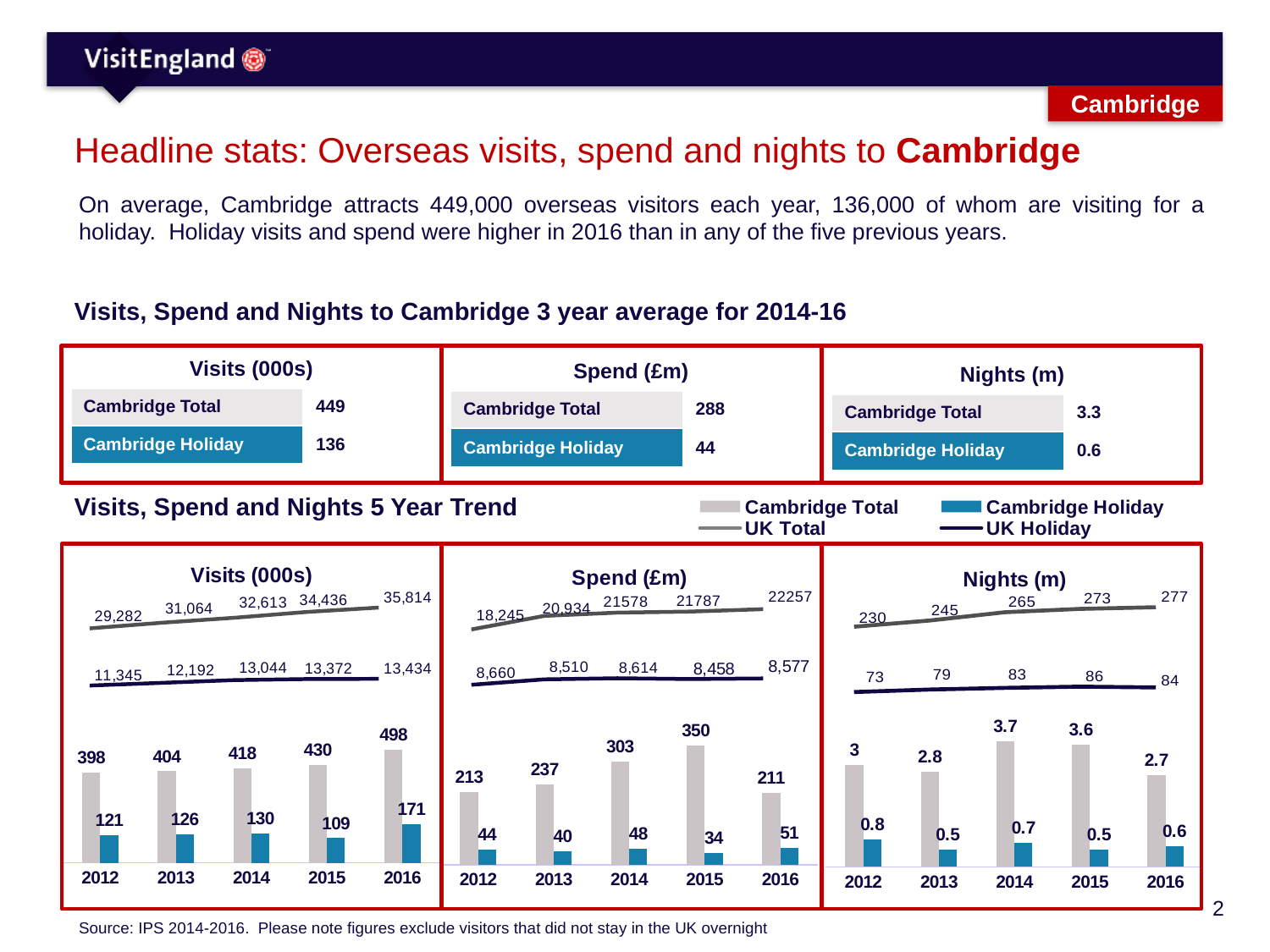
How many years are shown on the x axis of the Nights (m) trend chart? 5 In the Nights (m) trend chart, what is the difference between the Cambridge Total values for 2014 and 2016? 1 In the Spend (£m) trend chart, which year has the highest Cambridge Total value? 2015 In the Spend (£m) trend chart, is the Cambridge Holiday value for 2016 larger or smaller than the value for 2014? larger In the Visits (000s) trend chart, what is the Cambridge Total value for 2016? 498 In the Visits (000s) trend chart, which year has the lowest Cambridge Holiday value? 2015 In the Visits (000s) trend chart, does the UK Total line rise or fall from 2012 to 2016? rise In the Nights (m) trend chart, what is the UK Total value for 2014? 265 How many series does the legend for the 5 Year Trend charts list? 4 In the Visits (000s) trend chart, what is the difference between the UK Holiday values for 2016 and 2012? 2,089 In the Spend (£m) trend chart, what is the Cambridge Holiday value for 2015? 34 What kind of chart is the Visits (000s) 5 Year Trend chart? Combined bar and line chart